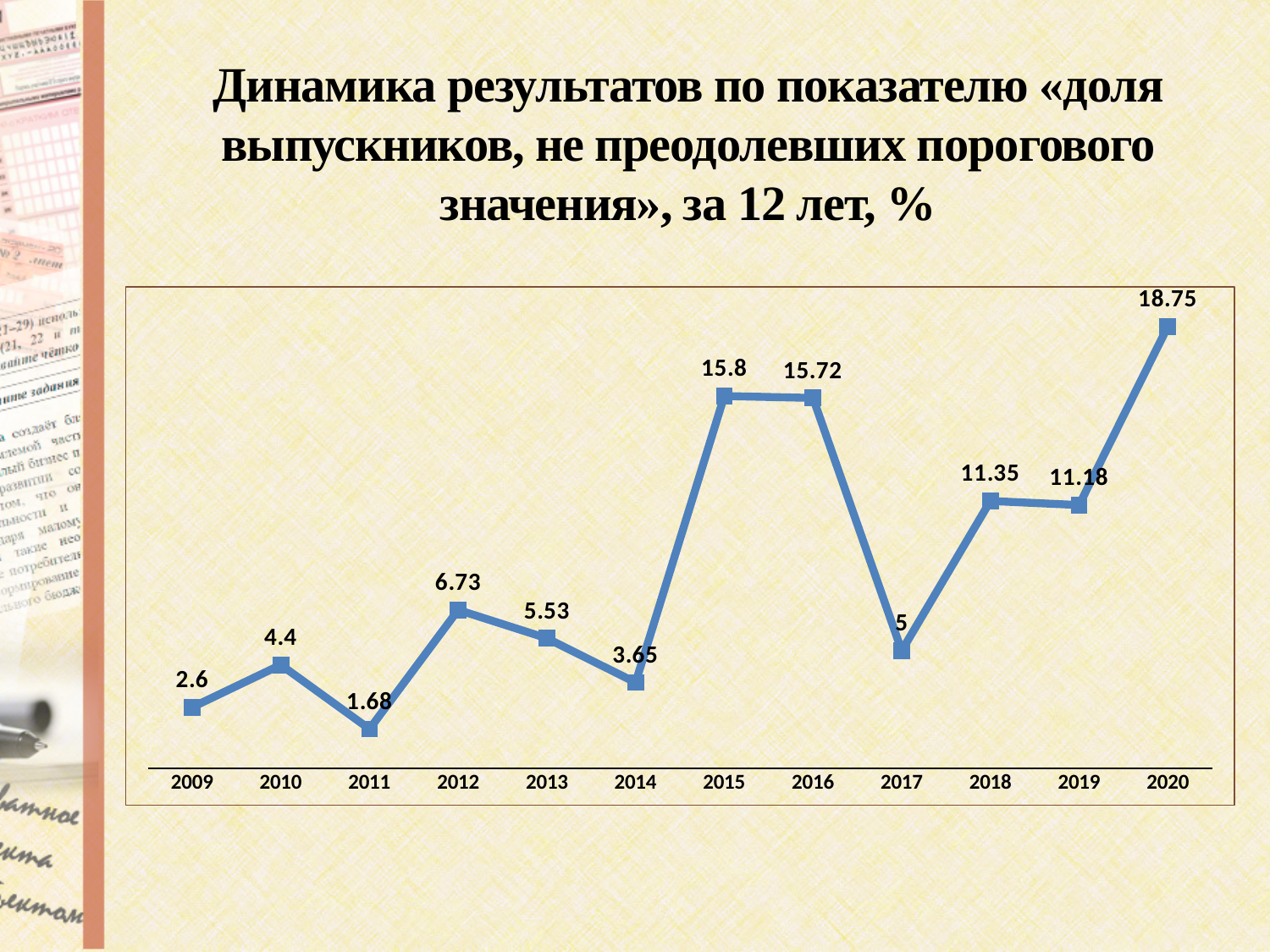
What kind of chart is shown on the slide? line chart Does the value rise or fall from 2016 to 2017? fall Which is larger, the value for 2015 or the value for 2016? 2015 What is the value for 2015? 15.8 What is the value for 2011? 1.68 What is the difference between the values for 2020 and 2019? 7.57 Which year has the lowest value? 2011 How many years are plotted on the chart? 12 What is the difference between the values for 2012 and 2013? 1.2 Which is larger, the value for 2010 or the value for 2014? 2010 What is the value for 2017? 5 Which year has the highest value? 2020